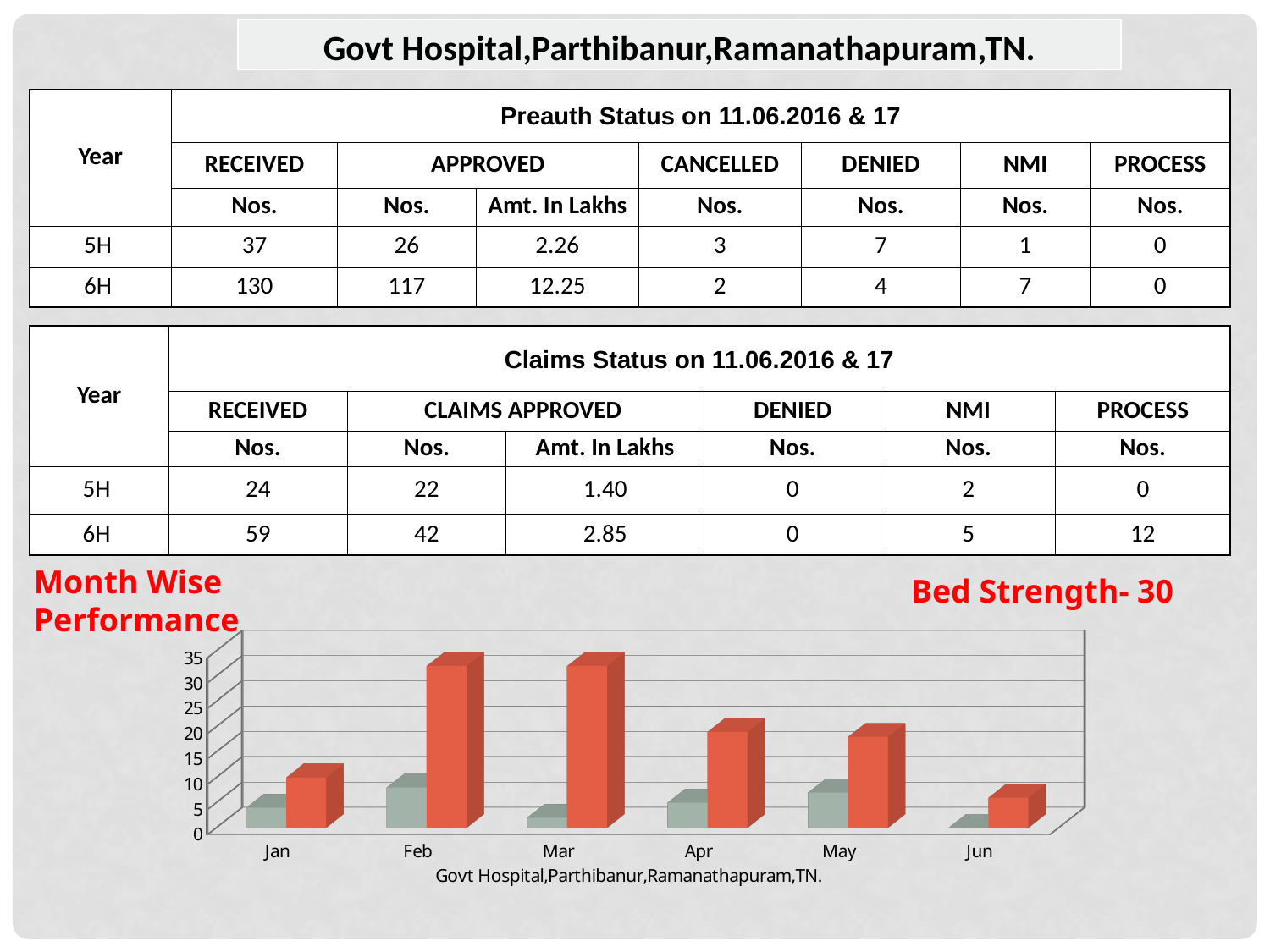
What kind of chart is shown under the 'Month Wise Performance' heading? bar chart In the bar chart, is the red bar for Feb greater or less than 25? greater In the bar chart, is the red bar for Jan greater or less than 5? greater In the bar chart, which month has the lowest value for the red (taller) series? Jun What text appears below the x axis of the bar chart? Govt Hospital,Parthibanur,Ramanathapuram,TN. In the bar chart, which is larger for the red series: Jan or Jun? Jan What is the highest value shown on the vertical axis of the bar chart? 35 In the bar chart, which is larger for the red series: Feb or Apr? Feb In the bar chart, is the red bar for Mar greater or less than 25? greater How many months are shown on the x axis of the bar chart? 6